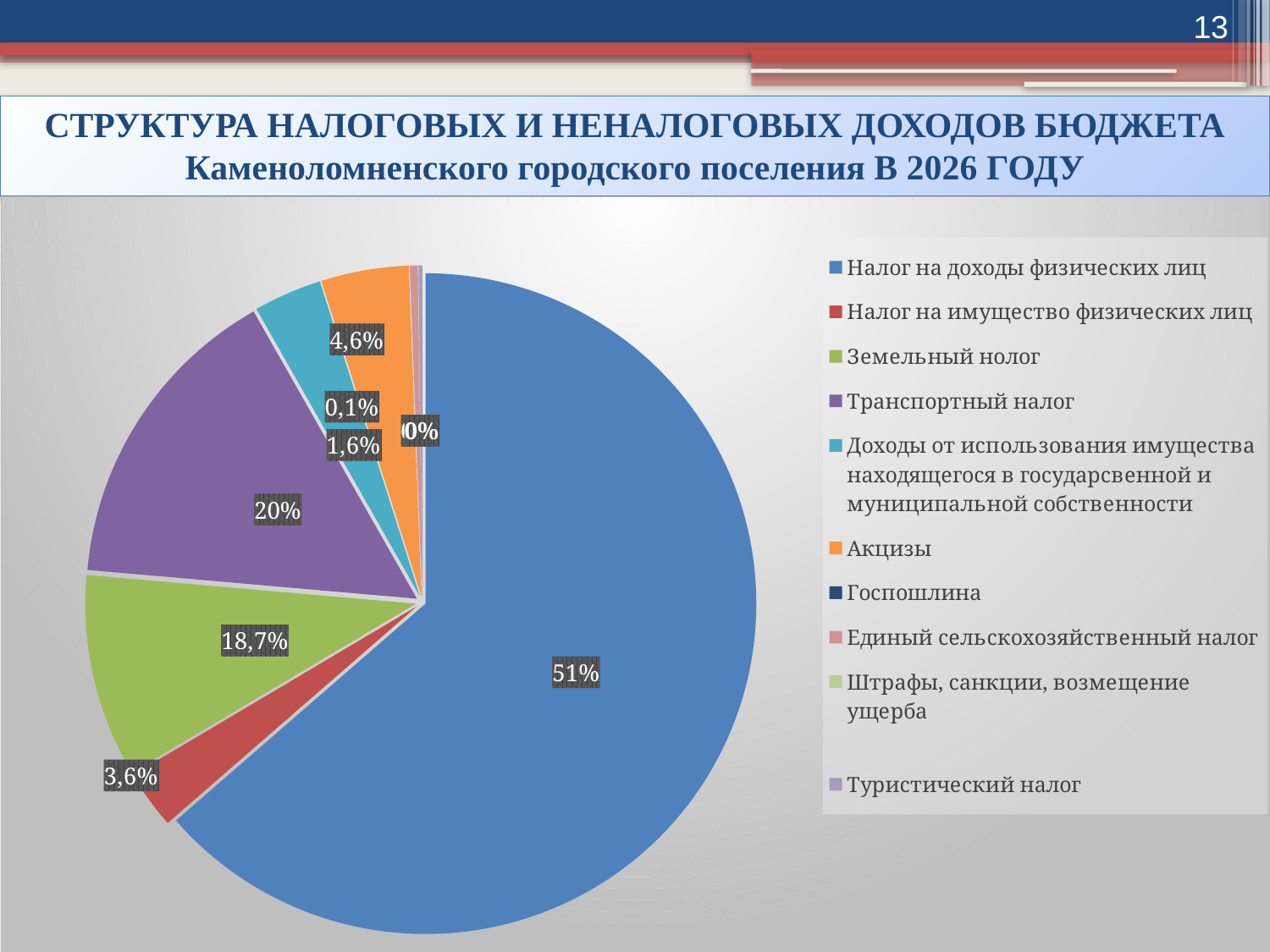
What percentage is shown for 'Доходы от использования имущества находящегося в государсвенной и муниципальной собственности'? 1,6% What share of the budget revenue does 'Налог на доходы физических лиц' account for? 51% What percentage is shown for 'Транспортный налог'? 20% How many categories are listed in the legend? 10 What percentage is shown for 'Налог на имущество физических лиц'? 3,6% What type of chart is shown on the slide? pie chart Which is larger: the share of 'Транспортный налог' or the share of 'Земельный нолог'? Транспортный налог What colour is the largest slice of the pie? blue What percentage is shown for 'Земельный нолог'? 18,7% Which category has the largest share of the pie? Налог на доходы физических лиц What percentage is shown for 'Акцизы'? 4,6% By how many percentage points does the share of 'Налог на доходы физических лиц' exceed the share of 'Транспортный налог'? 31%